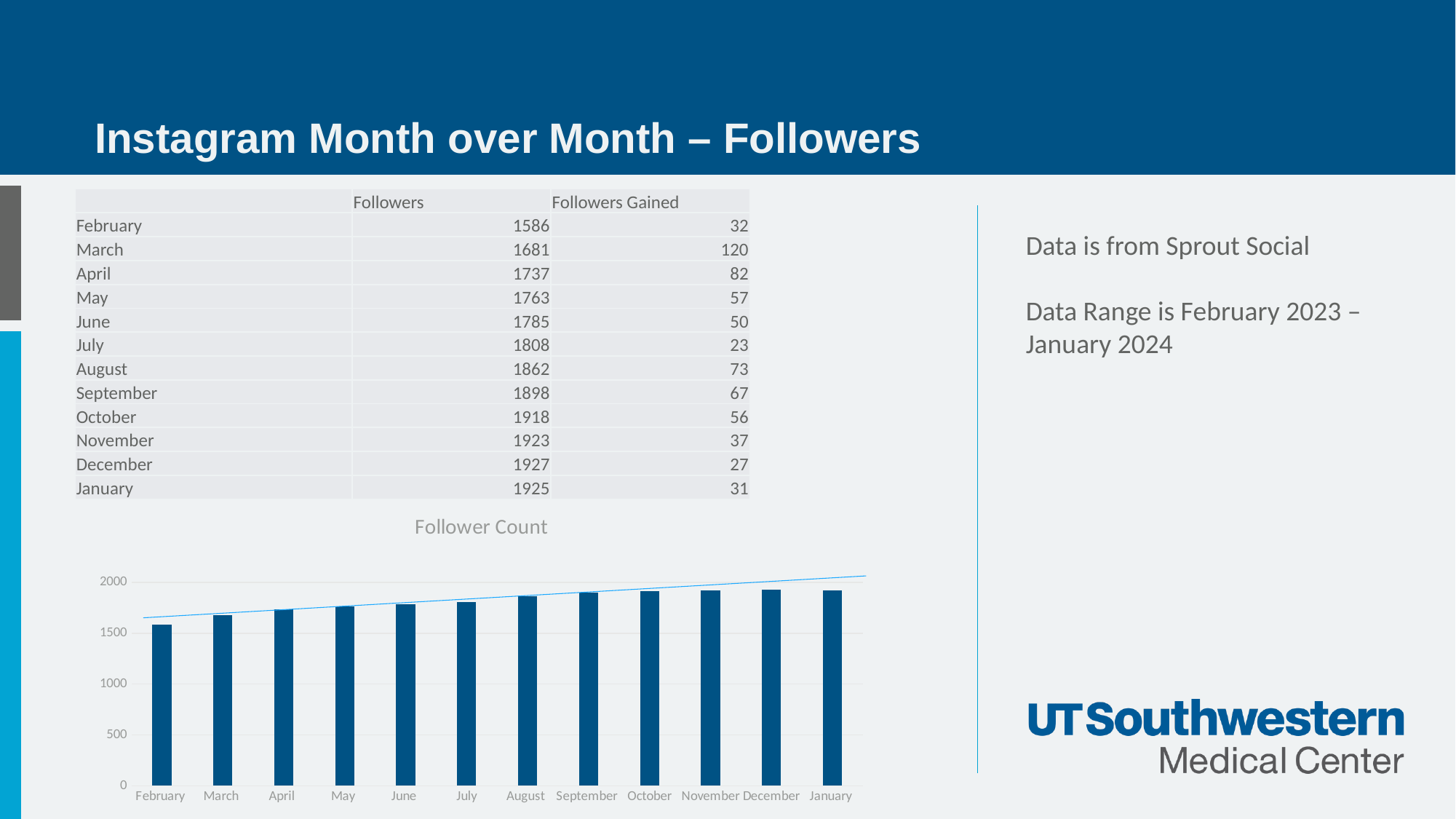
Is the value for July on the Follower Count chart greater or less than 2000? less Is the value for February on the Follower Count chart greater or less than 1500? greater Which month has the lowest bar on the Follower Count chart? February According to the table, how many followers were there in March? 1681 Using the table values, what is the difference in followers between January and February? 339 What is the title of the chart on the slide? Follower Count What kind of chart is the Follower Count chart? bar chart According to the table, how many followers were gained in March? 120 Do the follower counts generally rise or fall from February to January on the Follower Count chart? rise How many months are plotted on the Follower Count chart? 12 Which is larger on the Follower Count chart, the bar for March or the bar for February? March According to the table, which month has the highest follower count? December